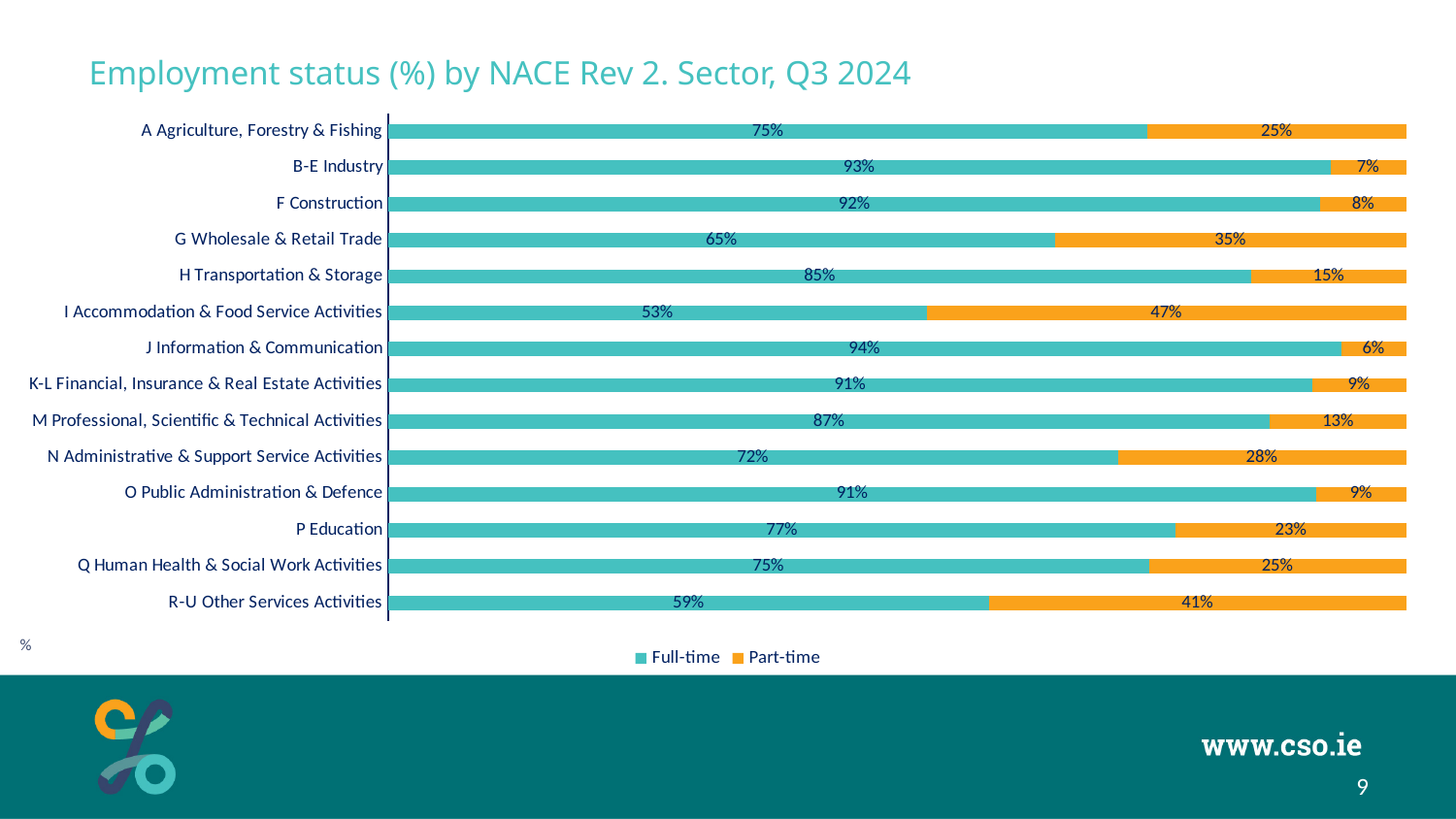
Which sector has the highest Full-time share? J Information & Communication What is the total of the stacked bar for H Transportation & Storage? 100% What is the Part-time value for I Accommodation & Food Service Activities? 47% What is the Part-time value for G Wholesale & Retail Trade? 35% Which sector has the lowest Full-time share? I Accommodation & Food Service Activities How many sectors are shown in the chart? 14 Which sector has the highest Part-time share? I Accommodation & Food Service Activities What is the Full-time value for J Information & Communication? 94% How many series does the legend list? 2 What kind of chart is shown on the slide? Stacked bar chart Which has a larger Part-time share, P Education or N Administrative & Support Service Activities? N Administrative & Support Service Activities What is the difference between the Full-time values for B-E Industry and R-U Other Services Activities? 34%